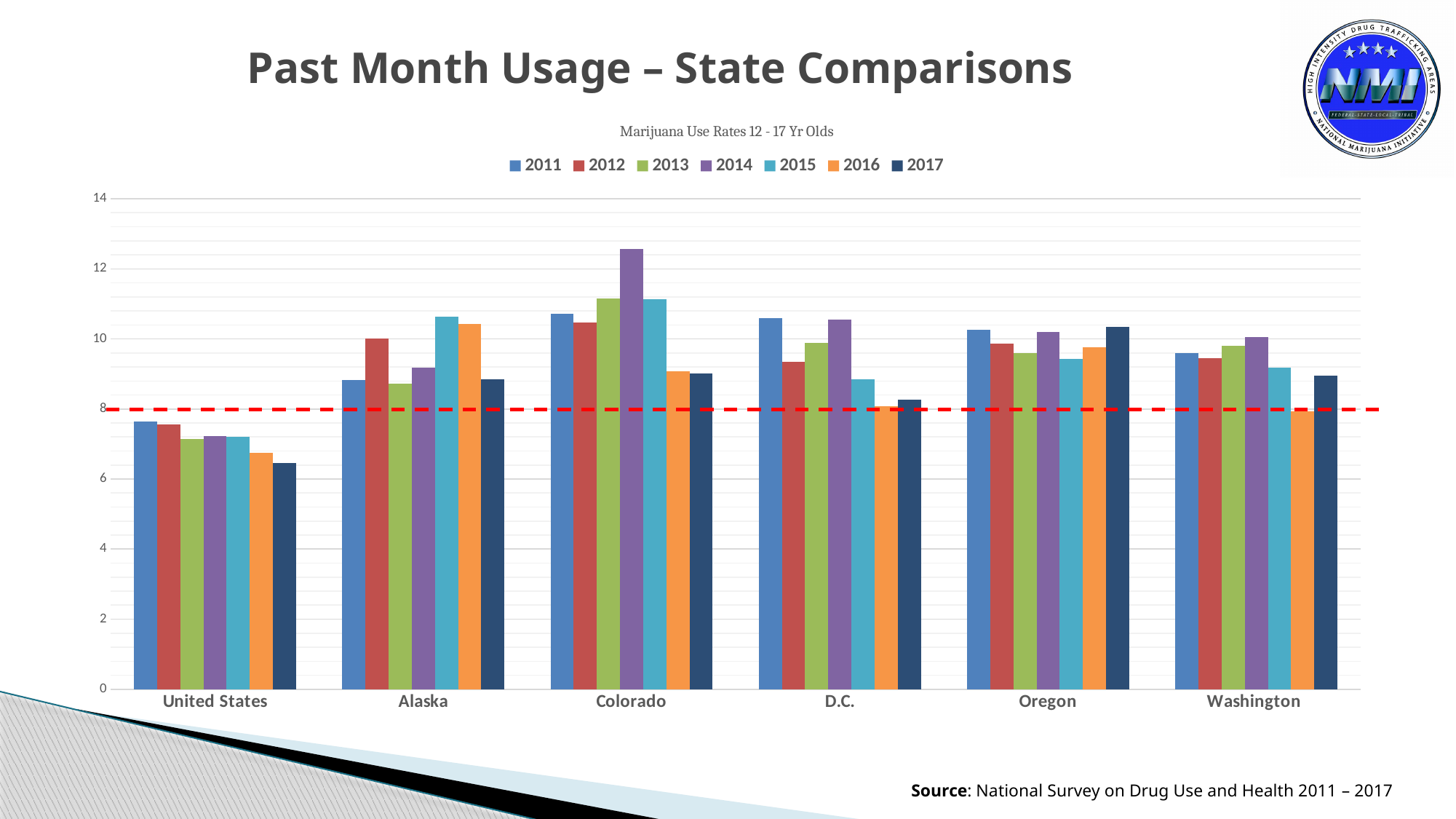
Which is larger: the 2017 value for Oregon or the 2017 value for Washington? Oregon What is the subtitle printed above the legend of the chart? Marijuana Use Rates 12 - 17 Yr Olds Is the value for the United States in 2017 greater or less than 8? less For Alaska, which is larger: the 2011 value or the 2012 value? 2012 How many series does the legend list? 7 What kind of chart is shown on the slide? bar chart Is the value for Colorado in 2014 greater or less than 12? greater How many states or regions are shown on the x axis? 6 Is the value for Alaska in 2015 greater or less than 10? greater Which state and year has the tallest bar in the chart? Colorado, 2014 Do the United States values generally rise or fall from 2011 to 2017? fall Which year has the lowest bar for the United States? 2017